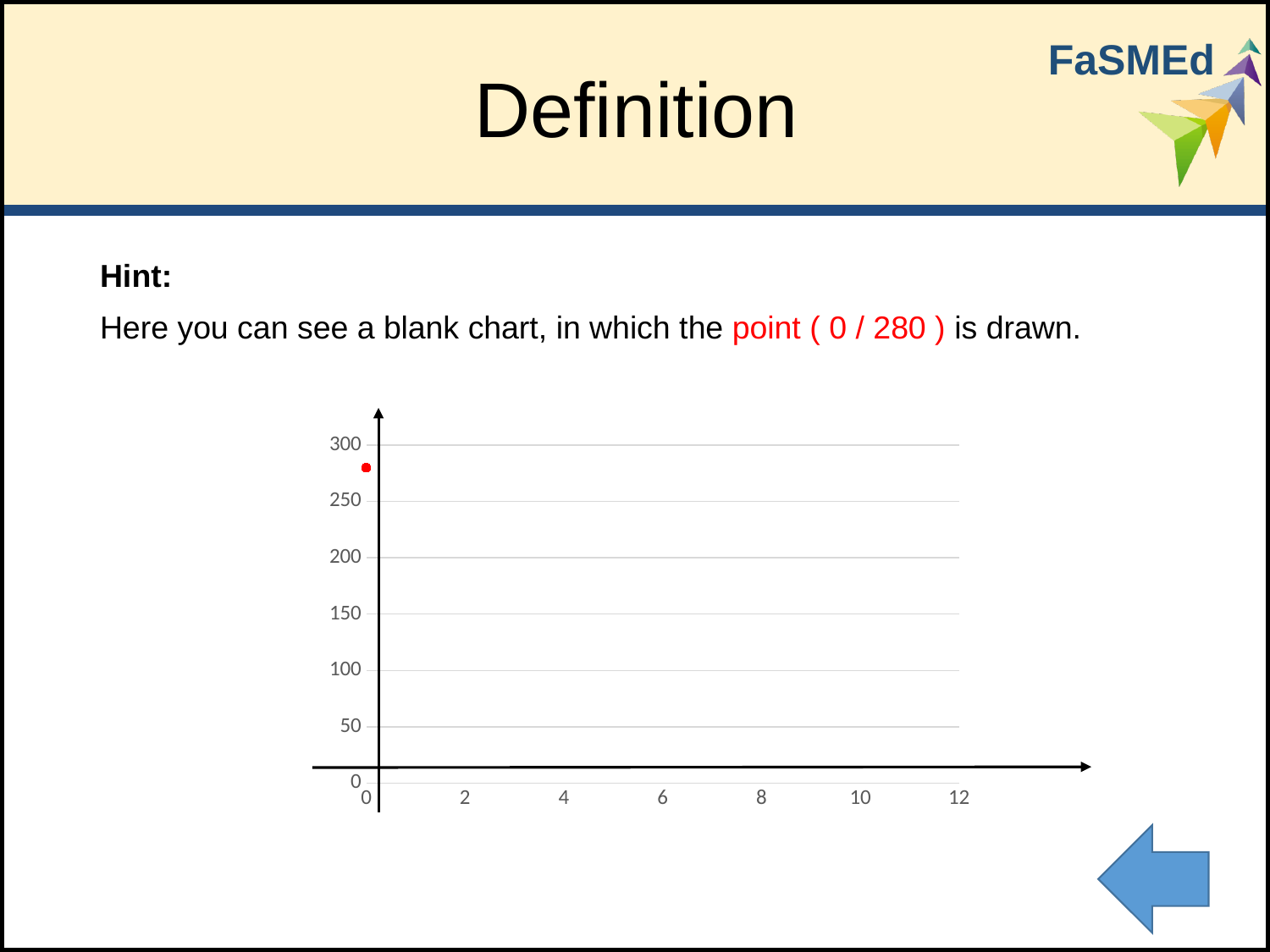
What is the x-value of the red point drawn on the chart? 0 Is the y-value of the plotted point greater or less than 250? greater How many data points are plotted on the chart? 1 What is the highest value labelled on the vertical axis? 300 What is the y-value of the red point drawn on the chart? 280 What kind of chart is shown on the slide? scatter chart Is the y-value of the plotted point greater or less than 300? less What is the highest value labelled on the horizontal axis? 12